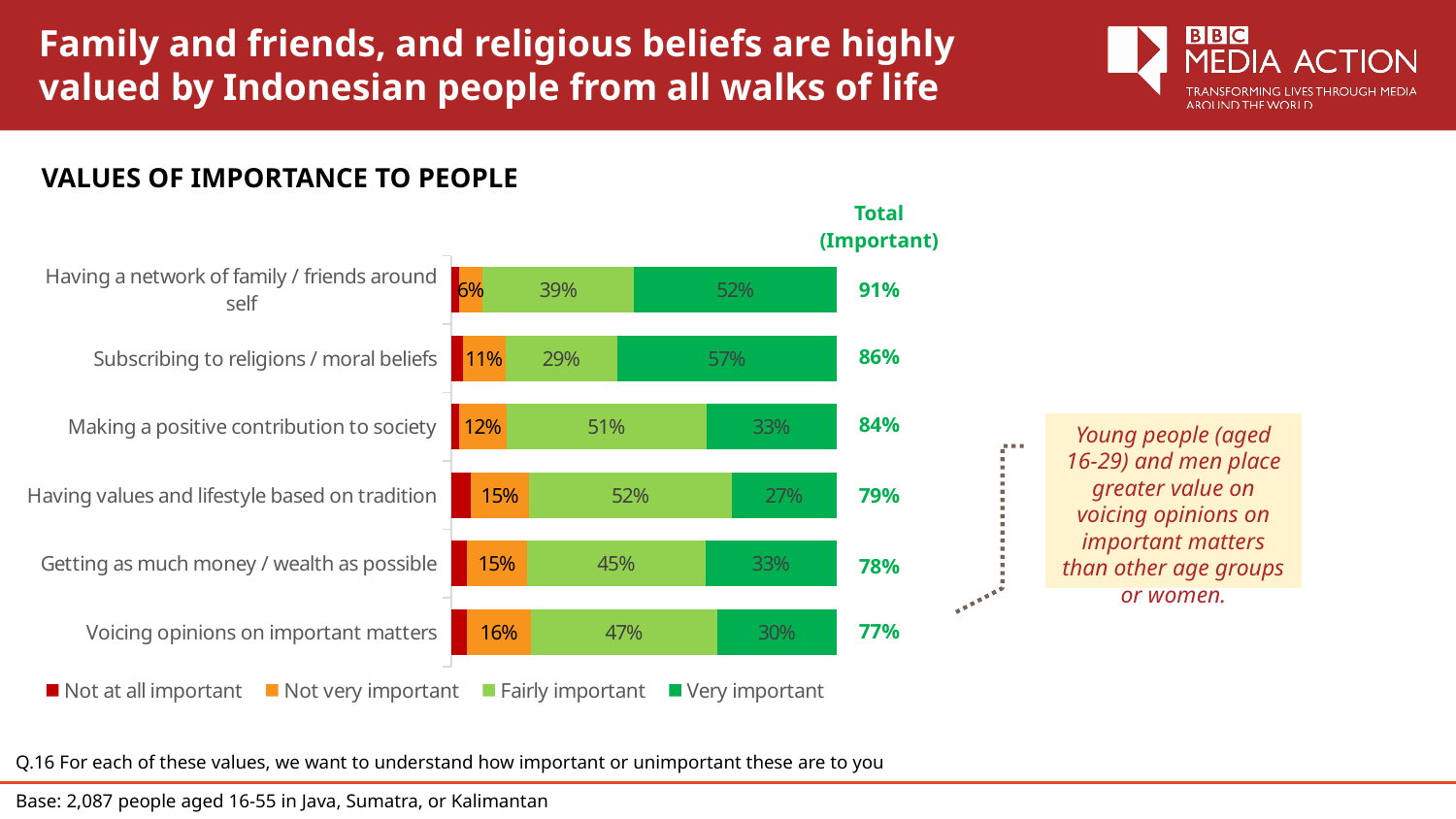
How many values (categories) are plotted in the chart? 6 What is the Total (Important) figure for 'Having a network of family / friends around self'? 91% Which has a larger 'Very important' share: 'Having values and lifestyle based on tradition' or 'Getting as much money / wealth as possible'? Getting as much money / wealth as possible Which value has the highest Total (Important) figure? Having a network of family / friends around self What kind of chart is shown on the slide? Stacked bar chart What is the difference between the Total (Important) figures for 'Subscribing to religions / moral beliefs' and 'Getting as much money / wealth as possible'? 8% How many series does the legend list? 4 What percentage of people rate 'Subscribing to religions / moral beliefs' as very important? 57% What is the 'Fairly important' value for 'Making a positive contribution to society'? 51% Which series is shown in dark green in the chart? Very important Which value has the lowest Total (Important) figure? Voicing opinions on important matters What is the 'Not very important' value for 'Voicing opinions on important matters'? 16%